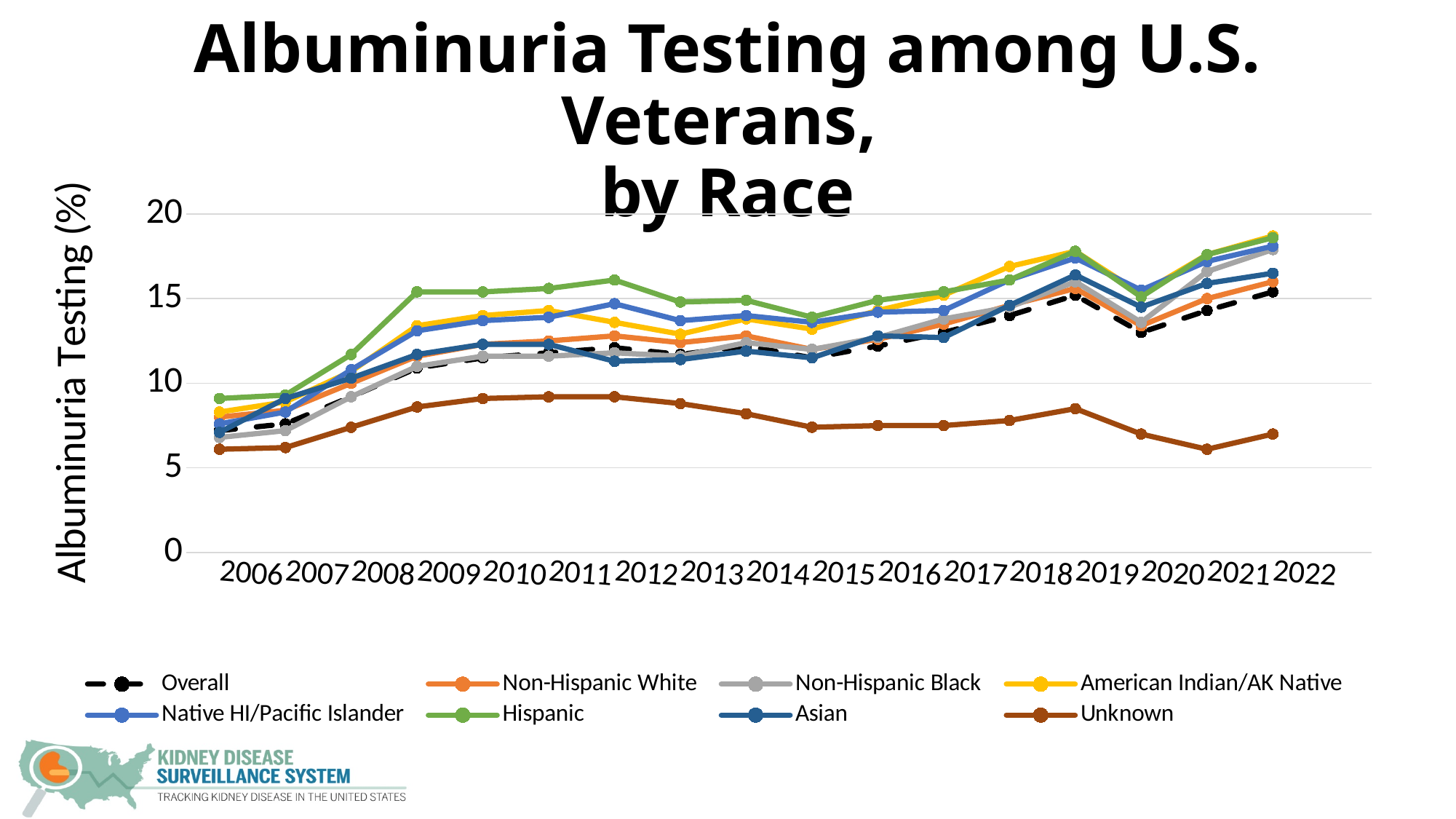
Which series has the lowest albuminuria testing percentage in 2022? Unknown How many years are shown along the x axis? 17 What kind of chart is shown on the slide? line chart What is the label on the y axis? Albuminuria Testing (%) How many series does the legend list? 8 Is the value for Unknown in 2022 greater or less than 10? less In 2010, which is larger: the value for Hispanic or the value for Unknown? Hispanic Which series has the highest albuminuria testing percentage in 2011? Hispanic Is the value for Hispanic in 2011 greater or less than 15? greater Does the Overall series rise or fall from 2006 to 2018? rise Is the value for Hispanic in 2022 greater or less than 15? greater